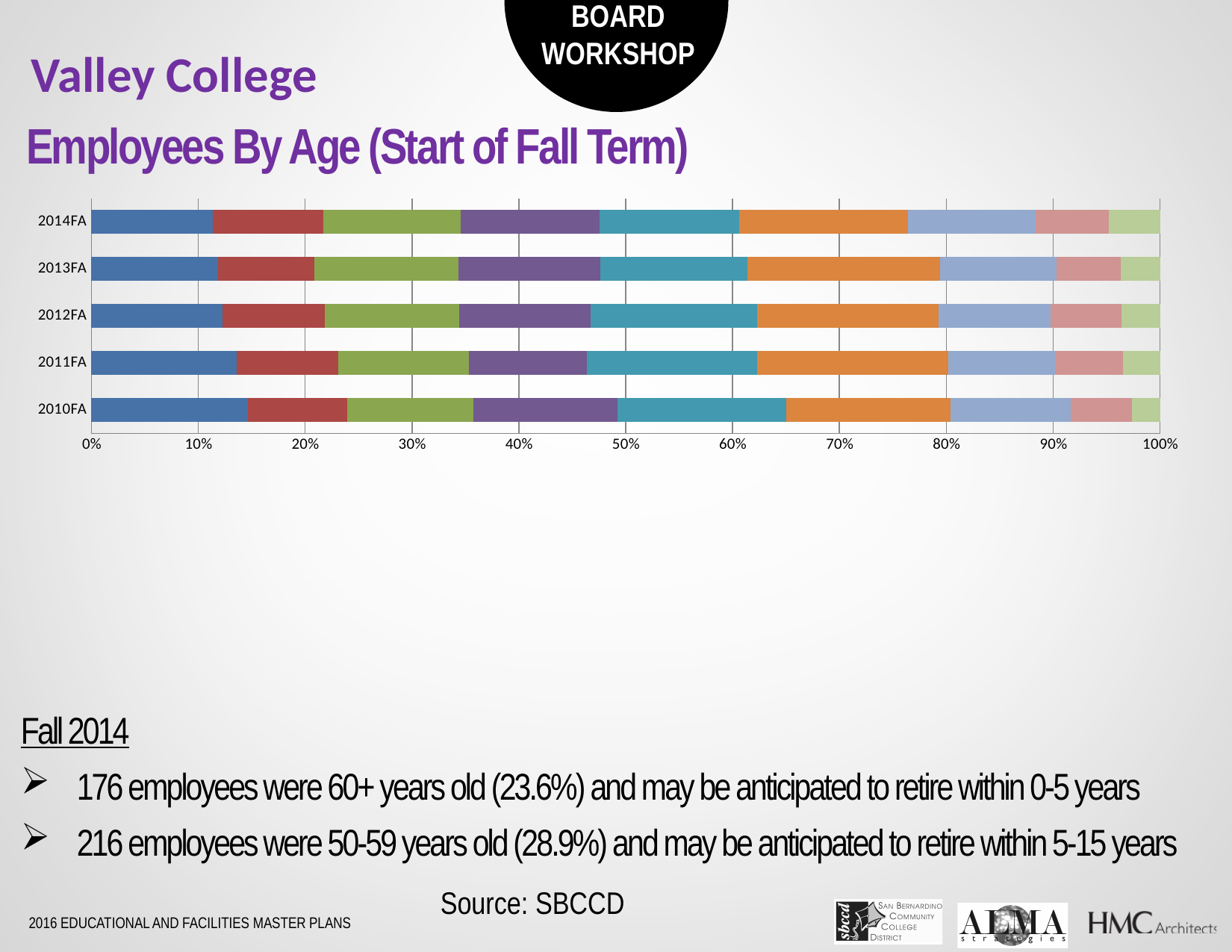
Is the leftmost (blue) segment for 2014FA greater or less than 20%? less What kind of chart is shown on the slide? Bar chart Which has the larger leftmost (blue) segment, 2010FA or 2014FA? 2010FA How many fall terms (categories) are plotted on the chart? 5 Does the chart include a legend identifying the age groups? No Does the teal segment for 2014FA end at a point greater or less than 70% on the axis? less Is the leftmost (blue) segment for 2010FA greater or less than 10%? greater What is the title of the chart on the slide? Employees By Age (Start of Fall Term) How many coloured segments make up each stacked bar? 9 Which fall term is listed at the bottom of the chart? 2010FA